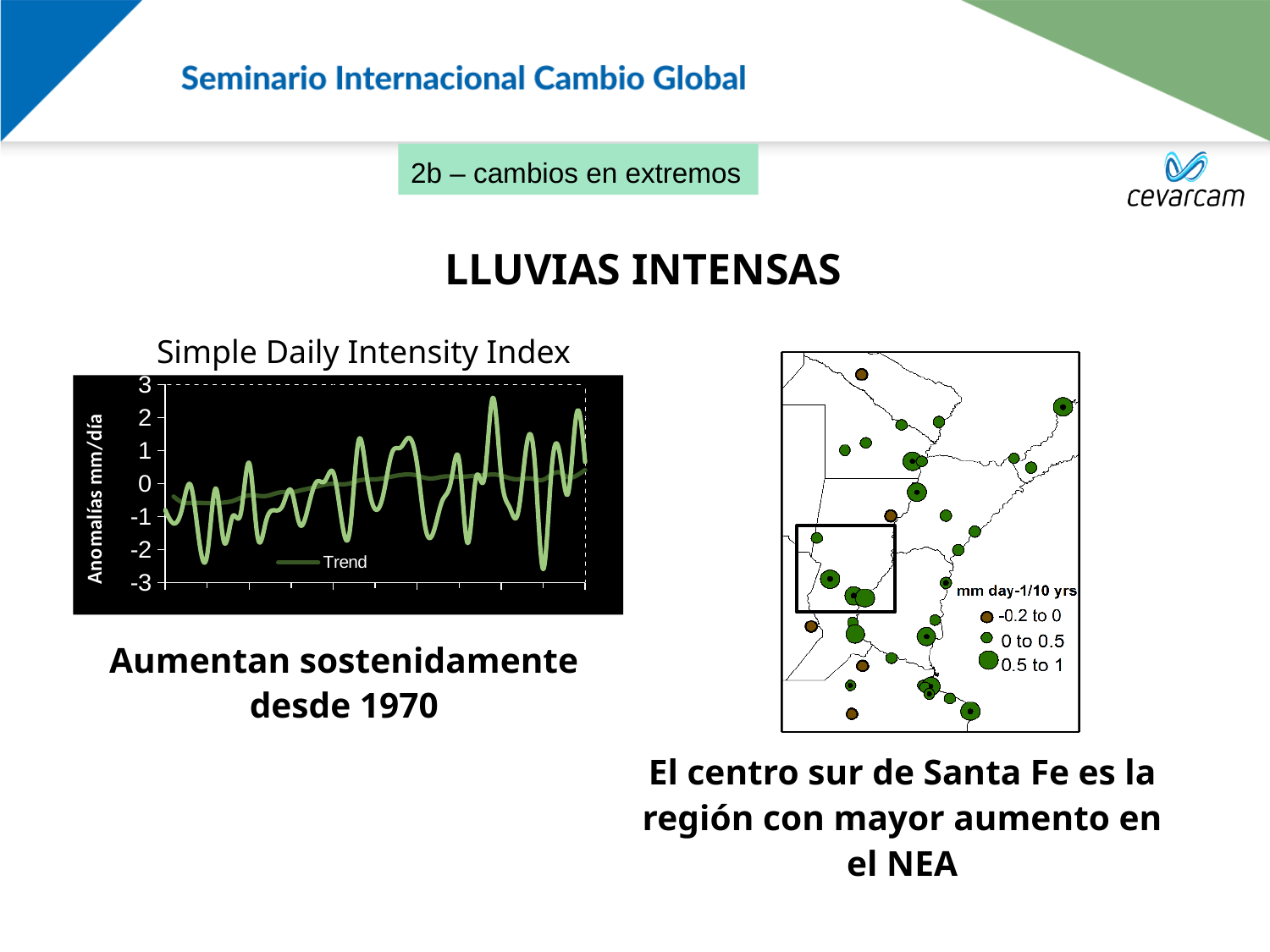
In the map on the right, what unit is given in the legend? mm day-1/10 yrs In the 'Simple Daily Intensity Index' chart, does the trend line rise or fall from left to right? rise In the 'Simple Daily Intensity Index' chart, is the highest peak of the anomaly line greater or less than 2? greater In the 'Simple Daily Intensity Index' chart, what is the label on the y axis? Anomalías mm/día In the 'Simple Daily Intensity Index' chart, what entry does the legend show? Trend What kind of chart is the 'Simple Daily Intensity Index' chart on the left? line chart In the map on the right, how many value ranges does the legend list? 3 In the 'Simple Daily Intensity Index' chart, is the trend line at the right end of the chart greater or less than 0? greater In the 'Simple Daily Intensity Index' chart, is the lowest dip of the anomaly line greater or less than -2? less